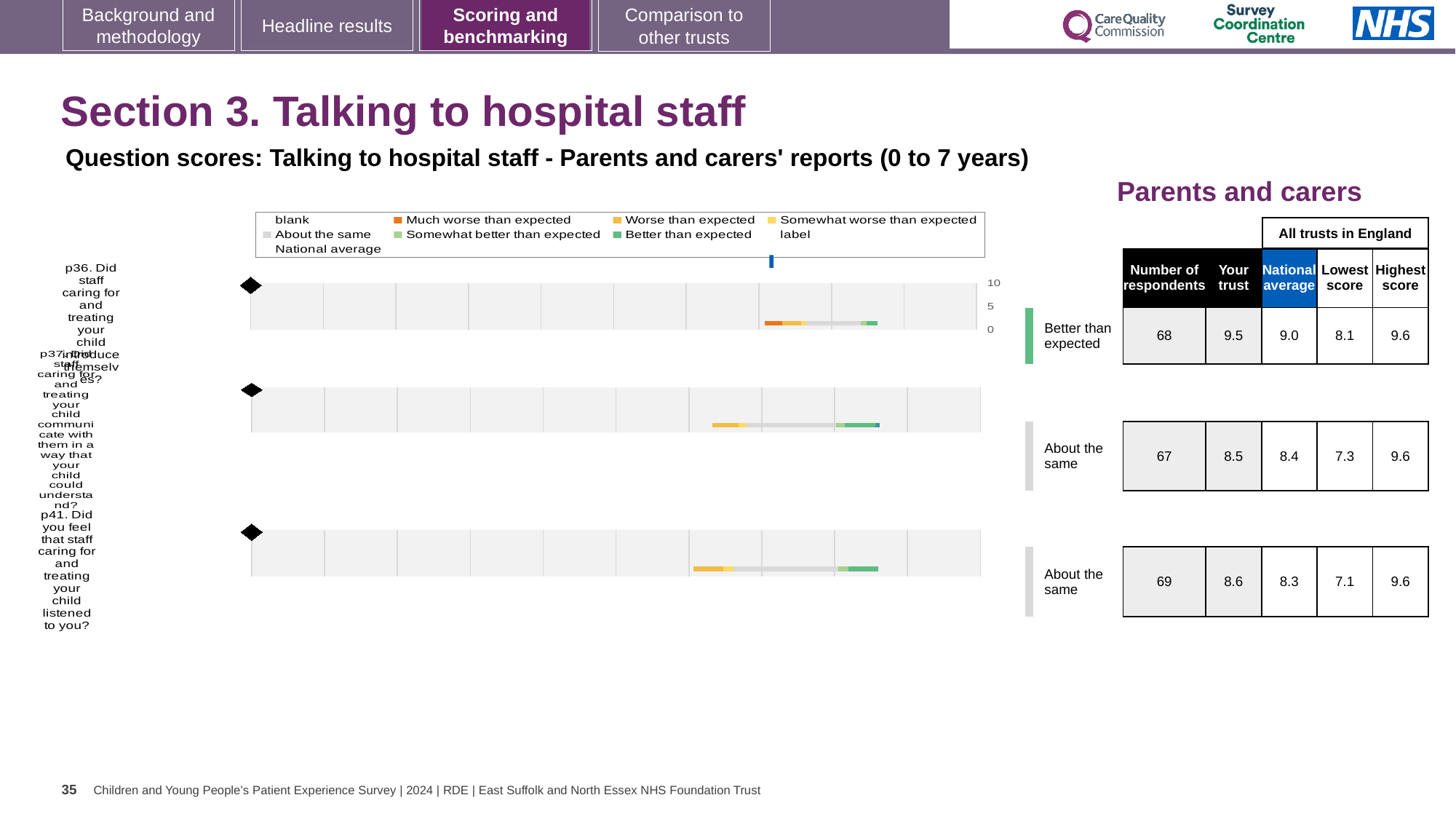
How many survey questions (bars) are plotted in the chart? 3 What is the difference between the 'Your trust' score and the national average for p36? 0.5 What kind of chart is shown on the slide? bar chart What benchmark category is p36 rated as? Better than expected Which of the three questions has the lowest 'Lowest score' value across all trusts in England? p41 Which of the three questions has the highest 'Your trust' score? p36 Which has a higher 'Your trust' score, p36 or p41? p36 What is the 'Your trust' score for p36 (Did staff caring for and treating your child introduce themselves?)? 9.5 How many respondents answered p41 (Did you feel that staff listened to you?)? 69 What is the title of the chart? Question scores: Talking to hospital staff - Parents and carers' reports (0 to 7 years) What is the lowest score across all trusts in England for p41? 7.1 What is the national average score for p37 (Did staff communicate with your child in a way they could understand?)? 8.4